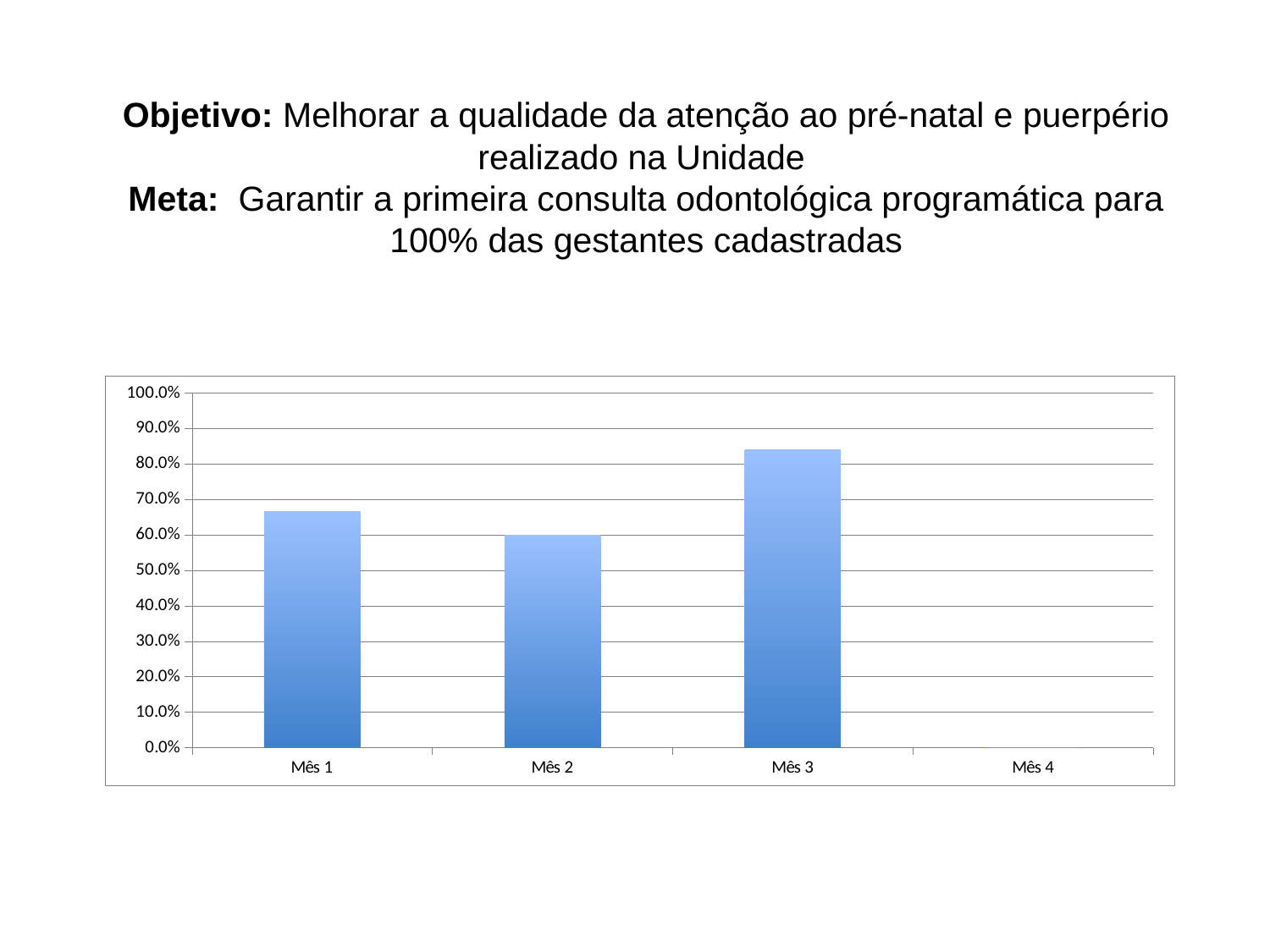
Is the value for Mês 1 greater or less than 70.0%? less Which is larger, the value for Mês 2 or the value for Mês 3? Mês 3 What kind of chart is shown on the slide? bar chart Which month on the x axis has no bar plotted? Mês 4 How many categories are shown on the x axis of the chart? 4 What is the highest value shown on the y axis of the chart? 100.0% Is the value for Mês 3 greater or less than 90.0%? less Is the value for Mês 3 greater or less than 80.0%? greater Which of the plotted bars is the shortest, Mês 1, Mês 2 or Mês 3? Mês 2 Which month has the tallest bar in the chart? Mês 3 Which is larger, the value for Mês 1 or the value for Mês 2? Mês 1